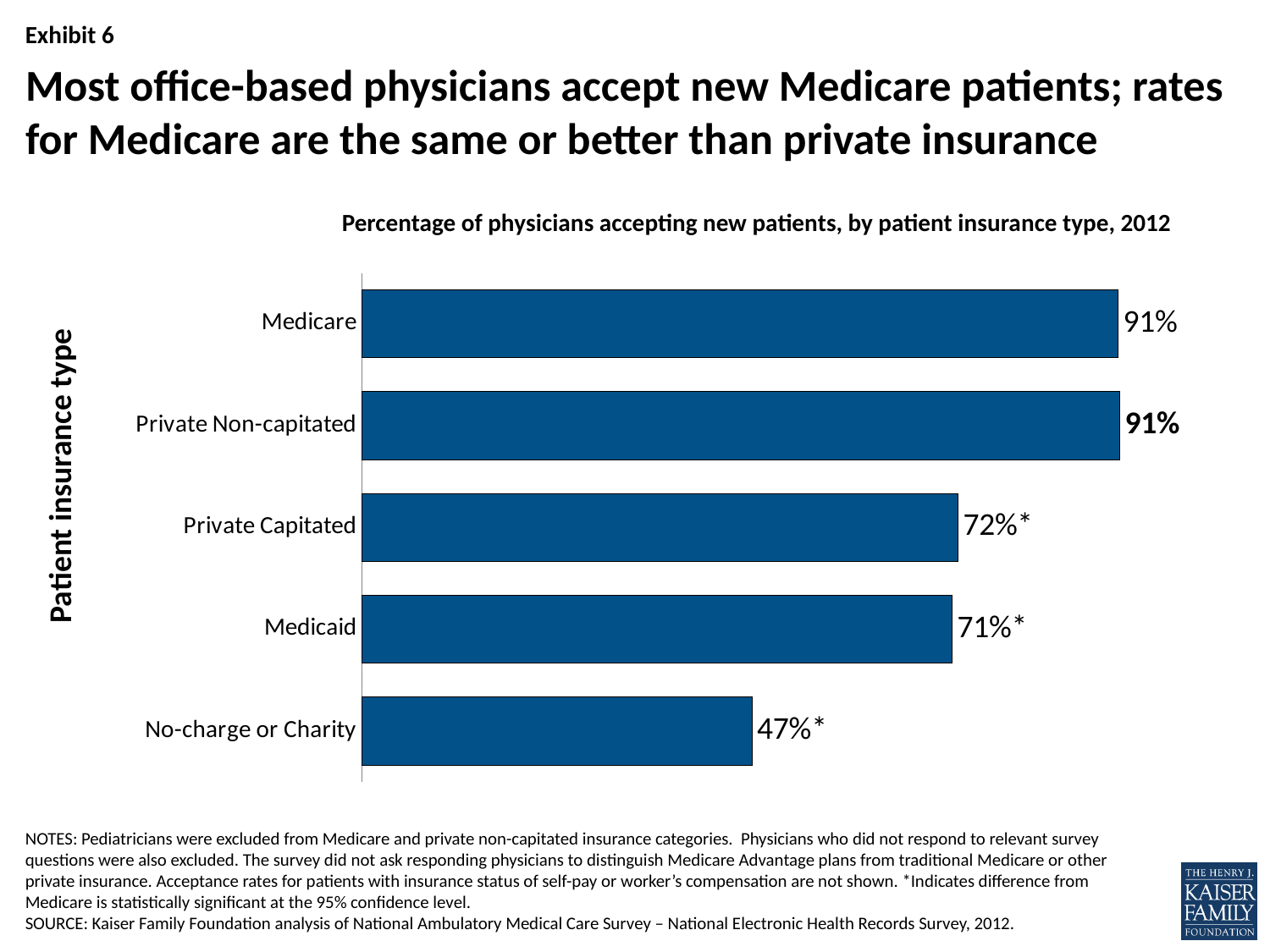
What is the value shown for No-charge or Charity? 47%* Which is larger, the value for Medicaid or the value for No-charge or Charity? Medicaid What is the value shown for Medicaid? 71%* What is the title of the chart? Percentage of physicians accepting new patients, by patient insurance type, 2012 What is the difference in percentage points between Medicare and No-charge or Charity? 44 What kind of chart is shown on the slide? Bar chart What is the difference in percentage points between Private Capitated and Medicaid? 1 How many patient insurance types are shown in the chart? 5 What is the value shown for Private Capitated? 72%* What is the label on the vertical axis of the chart? Patient insurance type What percentage of physicians accept new Medicare patients? 91% Which patient insurance type has the lowest percentage of physicians accepting new patients? No-charge or Charity